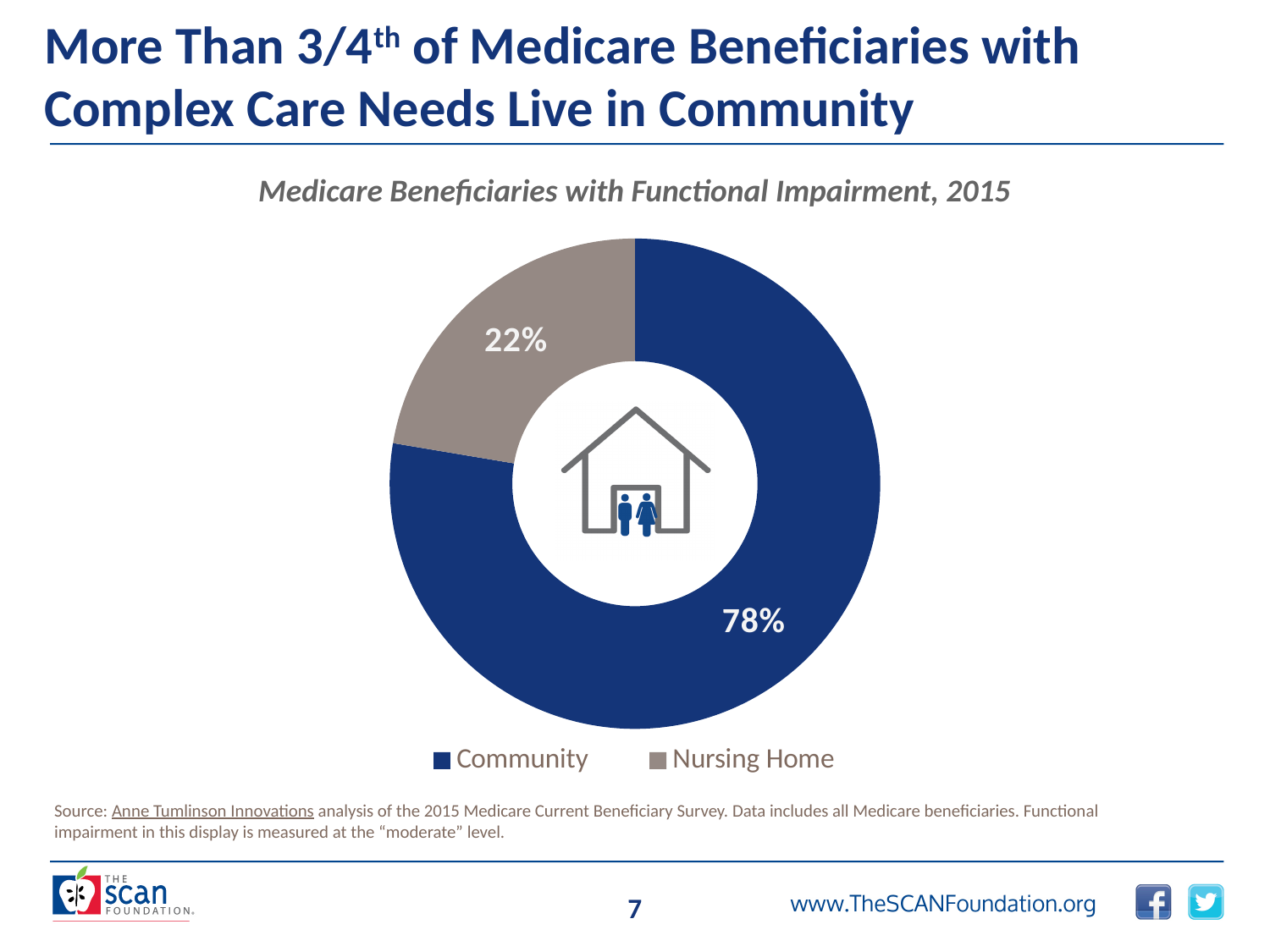
How many categories are shown in the chart? 2 What is the difference in percentage points between the Community and Nursing Home shares? 56 Which is larger, the Community share or the Nursing Home share? Community How many entries does the legend list? 2 Which category has the largest share of the chart? Community What colour represents the Nursing Home category in the chart? Gray Which category has the smallest share of the chart? Nursing Home What is the title of the chart? Medicare Beneficiaries with Functional Impairment, 2015 What percentage of Medicare beneficiaries with functional impairment live in the community? 78% What percentage of Medicare beneficiaries with functional impairment live in a nursing home? 22% What share of the chart does the Community slice represent? 78% What kind of chart is shown on the slide? Doughnut (pie) chart